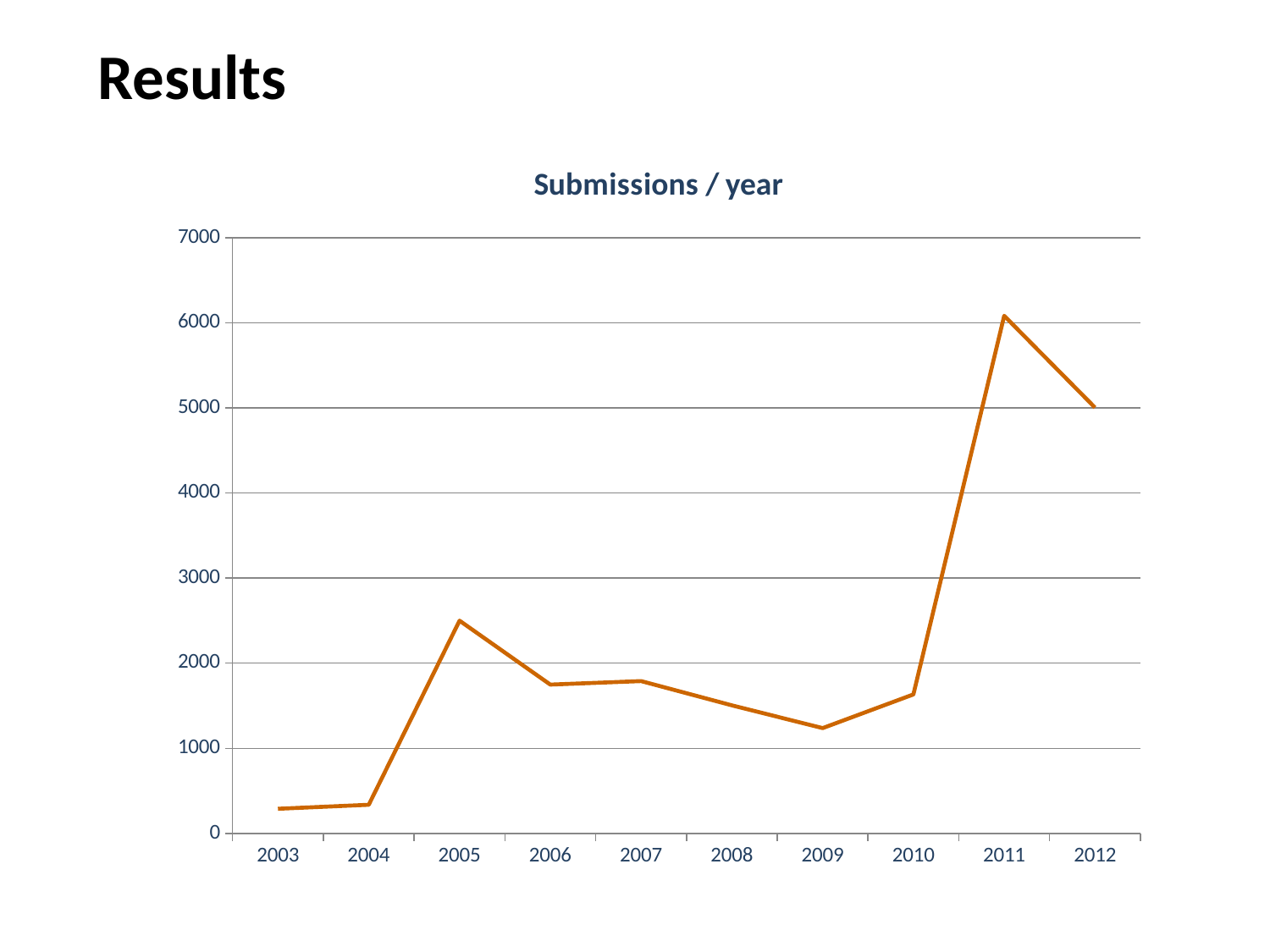
Which year has more submissions, 2010 or 2011? 2011 Is the value for 2009 greater or less than 1000? greater Which year has more submissions, 2005 or 2006? 2005 Which year has the highest number of submissions? 2011 Which year has the lowest number of submissions? 2003 Is the value for 2005 greater or less than 2000? greater Is the value for 2004 greater or less than 1000? less How many years are plotted on the x axis? 10 Do submissions rise or fall from 2011 to 2012? fall What kind of chart is shown on the slide? line chart What is the title of the chart? Submissions / year